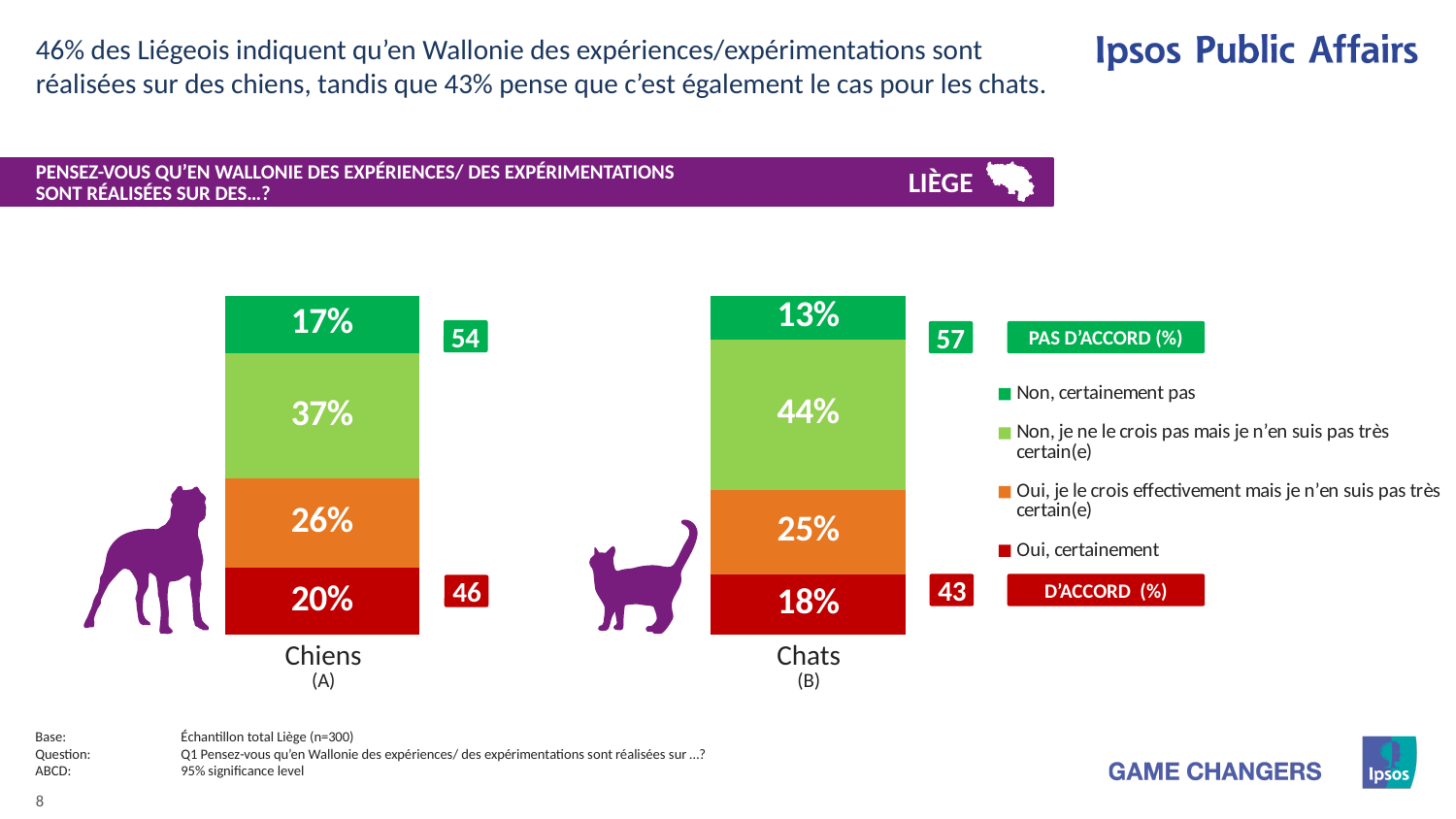
How many series does the legend list? 4 How many categories are shown on the x axis of the chart? 2 What kind of chart is shown on the slide? Stacked bar chart Which colour represents "Oui, certainement" in the chart? Red What is the value of the "Oui, je le crois effectivement mais je n'en suis pas très certain(e)" segment for Chats? 25% What is the difference between the "Non, je ne le crois pas mais je n'en suis pas très certain(e)" values for Chats and Chiens? 7 percentage points What is the total "D'accord (%)" figure shown for Chiens? 46 What is the value of the "Non, je ne le crois pas mais je n'en suis pas très certain(e)" segment for Chiens? 37% What is the total "Pas d'accord (%)" figure shown for Chats? 57 Which category has the larger "Oui, certainement" share, Chiens or Chats? Chiens What percentage of respondents answered "Non, certainement pas" for Chats? 13% What percentage of Liège respondents answered "Oui, certainement" for Chiens? 20%